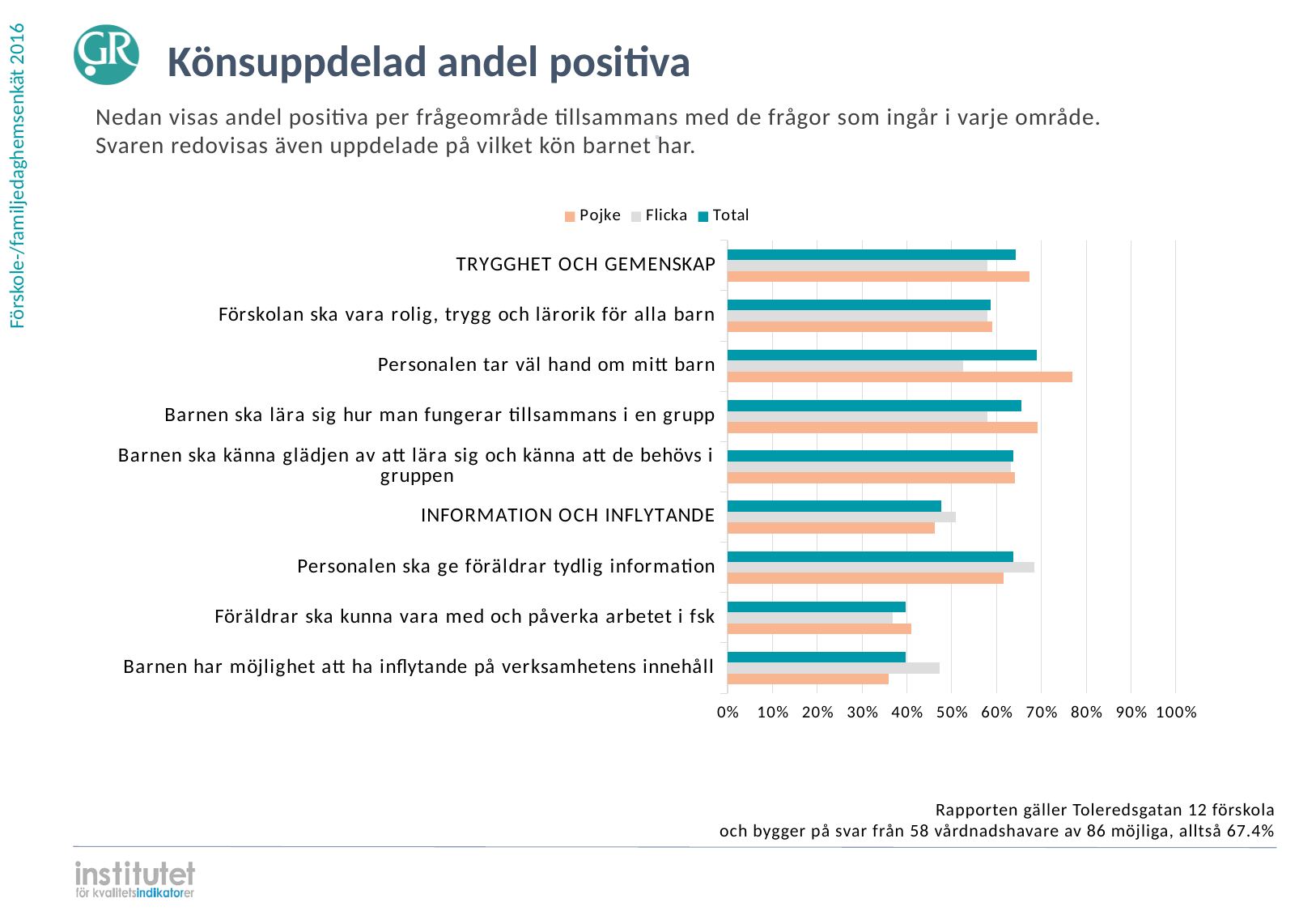
For which category is the Flicka value lowest? Föräldrar ska kunna vara med och påverka arbetet i fsk For which category is the Pojke value lowest? Barnen har möjlighet att ha inflytande på verksamhetens innehåll Is the Total value for 'Föräldrar ska kunna vara med och påverka arbetet i fsk' greater or less than 50%? less Is the Pojke value for 'Personalen tar väl hand om mitt barn' greater or less than 70%? greater Which series are listed in the chart legend? Pojke, Flicka, Total How many series does the legend list? 3 For 'Personalen tar väl hand om mitt barn', which is larger: the Pojke value or the Flicka value? Pojke For 'Barnen har möjlighet att ha inflytande på verksamhetens innehåll', which is larger: the Flicka value or the Pojke value? Flicka For which category is the Pojke value highest? Personalen tar väl hand om mitt barn What kind of chart is shown on the slide? Bar chart How many categories are plotted on the y axis of the chart? 9 Is the Flicka value for 'Personalen ska ge föräldrar tydlig information' greater or less than 60%? greater